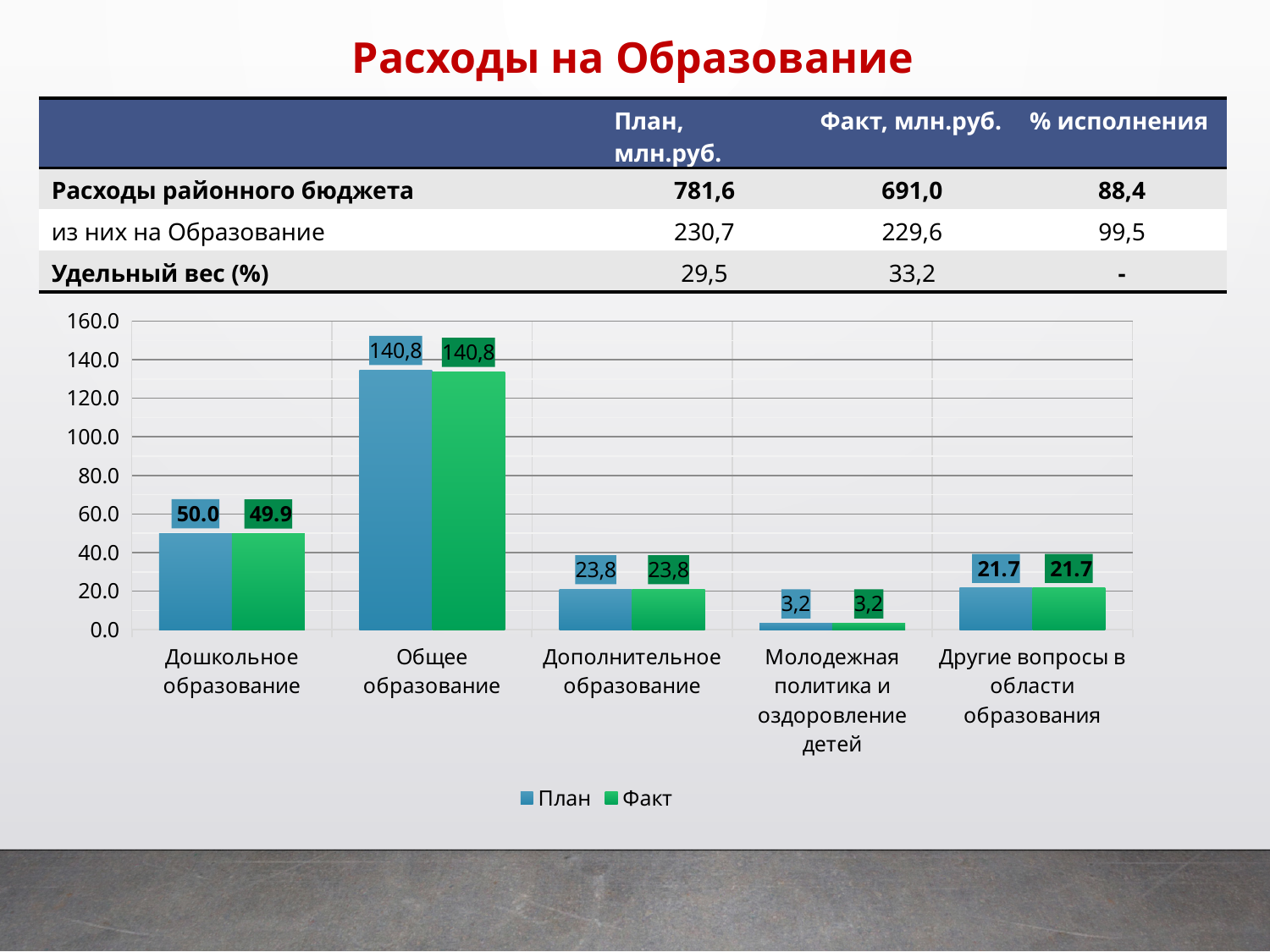
How many categories are shown on the x axis of the chart? 5 Which category has the lowest Факт value? Молодежная политика и оздоровление детей What is the План value for Дошкольное образование? 50.0 Which category has the highest План value? Общее образование What is the Факт value for Дошкольное образование? 49.9 What is the Факт value for Общее образование? 140,8 What kind of chart is shown on the slide? Bar chart What is the Факт value for Молодежная политика и оздоровление детей? 3,2 What is the План value for Дополнительное образование? 23,8 How many series does the chart legend list? 2 What is the difference between the План and Факт values for Дошкольное образование? 0.1